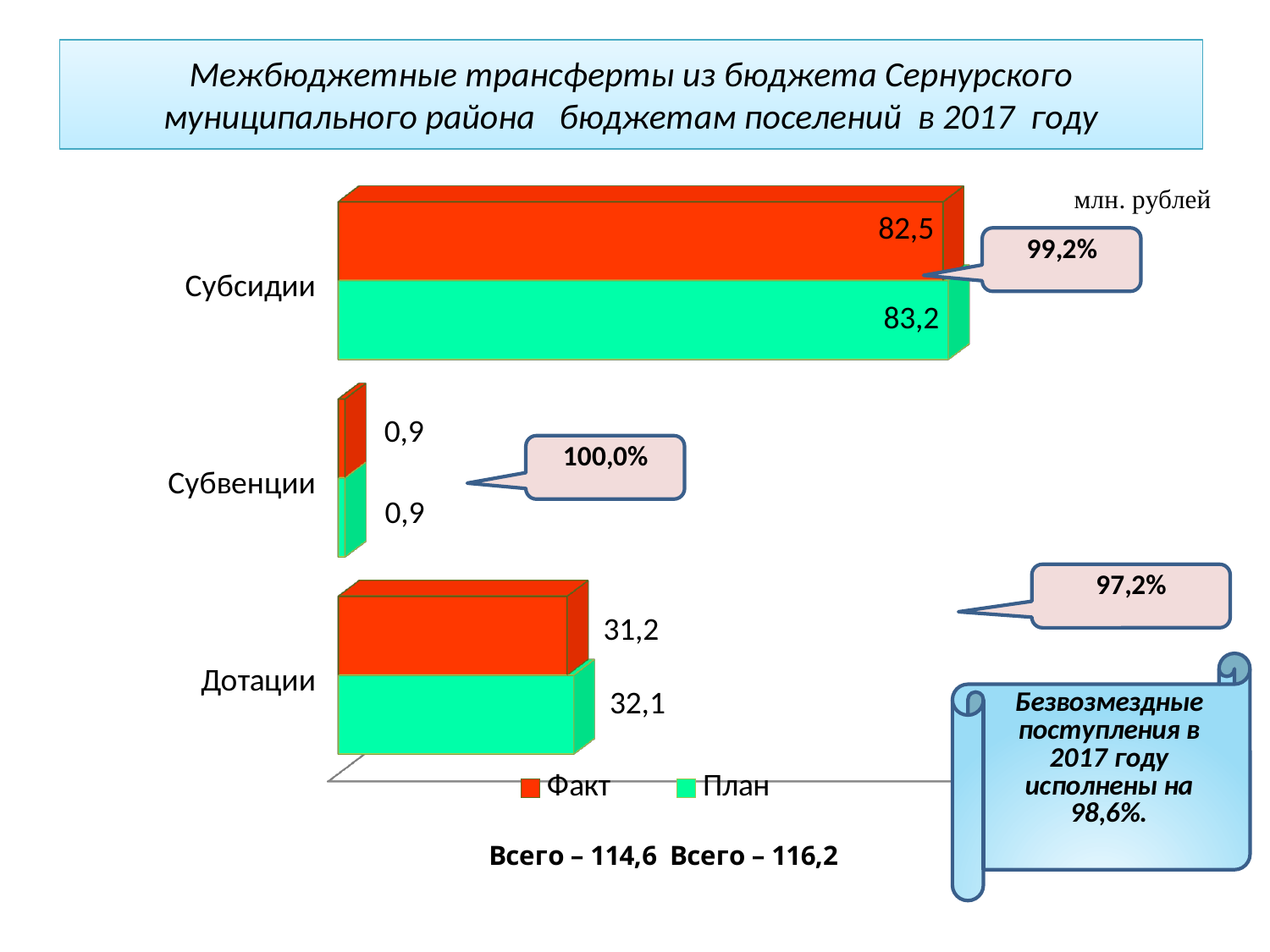
How many series does the legend list? 2 What is the Факт value for Субсидии? 82,5 What kind of chart is shown on the slide? Bar chart Which is larger for Дотации, the Факт value or the План value? План What is the difference between the План and Факт values for Дотации? 0,9 What is the План value for Субвенции? 0,9 What is the Факт value for Дотации? 31,2 What is the План value for Субсидии? 83,2 Which category has the lowest План value? Субвенции What is the difference between the План and Факт values for Субсидии? 0,7 How many categories are shown on the chart? 3 Which category has the highest Факт value? Субсидии